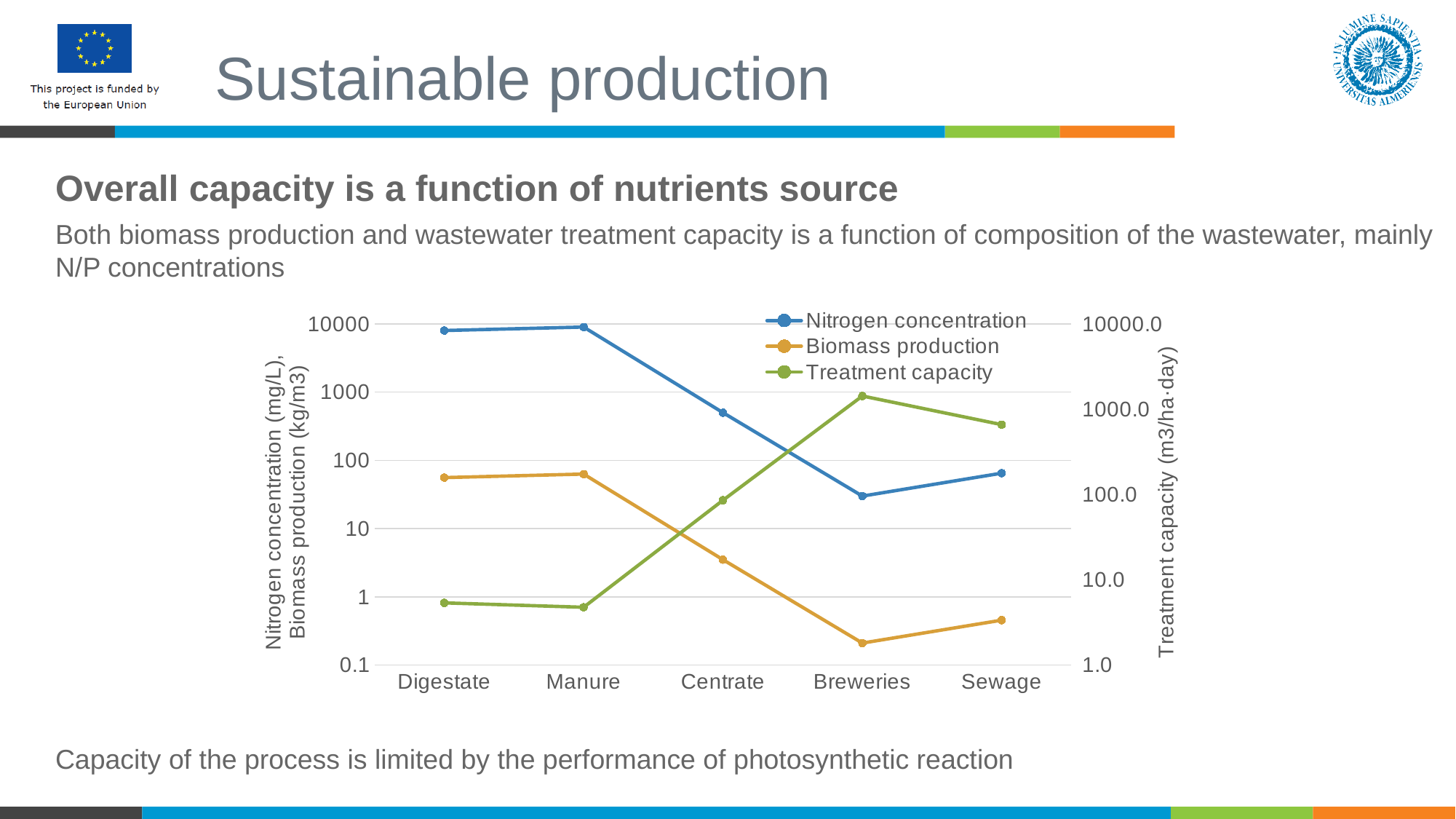
Which category has the lowest Biomass production? Breweries Does the Nitrogen concentration rise or fall from Manure to Breweries? fall Is the Nitrogen concentration for Centrate greater or less than 1000? less Which category has the highest Treatment capacity? Breweries What is the label of the right-hand vertical axis? Treatment capacity (m3/ha·day) Which has the larger Nitrogen concentration, Centrate or Sewage? Centrate Which category has the lowest Nitrogen concentration? Breweries What kind of chart is shown on the slide? line chart How many categories are shown on the x axis? 5 Is the Biomass production for Breweries greater or less than 1? less How many series does the legend list? 3 Is the Treatment capacity for Breweries greater or less than 1000.0? greater